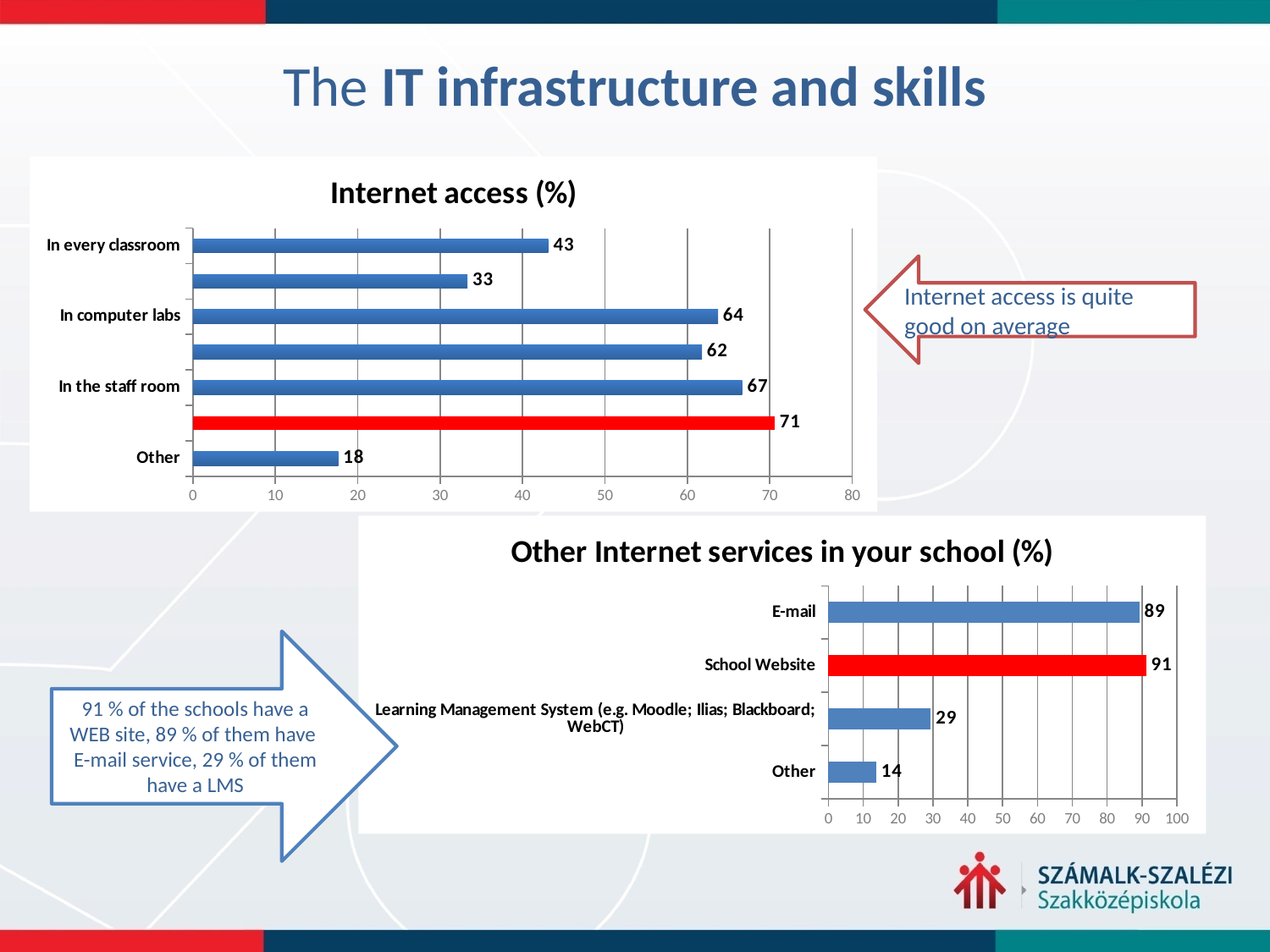
In the 'Other Internet services in your school (%)' chart, what is the value for 'School Website'? 91 In the 'Other Internet services in your school (%)' chart, which category has the lowest value? Other In the 'Other Internet services in your school (%)' chart, how many categories are shown? 4 In the 'Internet access (%)' chart, what is the value for 'In computer labs'? 64 In the 'Internet access (%)' chart, what kind of chart is shown? Bar chart In the 'Internet access (%)' chart, which is larger: the value for 'In every classroom' or the value for 'Other'? In every classroom In the 'Internet access (%)' chart, what is the value for 'Other'? 18 In the 'Internet access (%)' chart, what is the value for 'In the staff room'? 67 In the 'Internet access (%)' chart, what is the difference between the values for 'In the staff room' and 'In computer labs'? 3 In the 'Other Internet services in your school (%)' chart, what is the difference between the values for 'E-mail' and 'Other'? 75 In the 'Internet access (%)' chart, what is the value for 'In every classroom'? 43 In the 'Other Internet services in your school (%)' chart, what is the value for 'Learning Management System (e.g. Moodle; Ilias; Blackboard; WebCT)'? 29